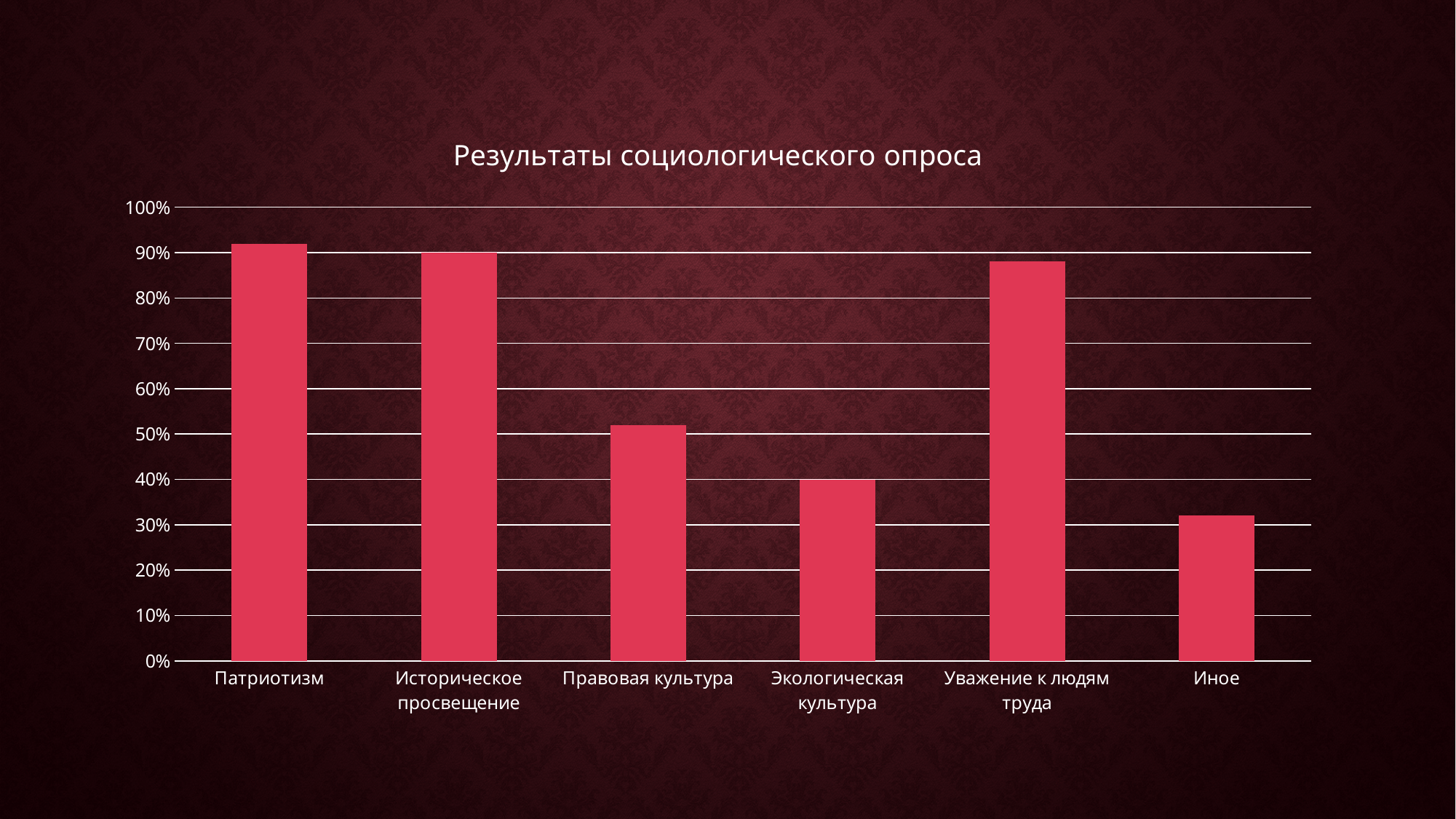
Is the value for Правовая культура greater or less than 50%? greater Is the value for Уважение к людям труда greater or less than 90%? less What is the value for Историческое просвещение? 90% Which is larger, the value for Правовая культура or the value for Экологическая культура? Правовая культура How many categories are shown on the x axis of the chart? 6 What is the title of the chart? Результаты социологического опроса Is the value for Иное greater or less than 30%? greater What kind of chart is shown on the slide? Bar chart What is the value for Экологическая культура? 40% Which category has the highest value? Патриотизм Which category has the lowest value? Иное